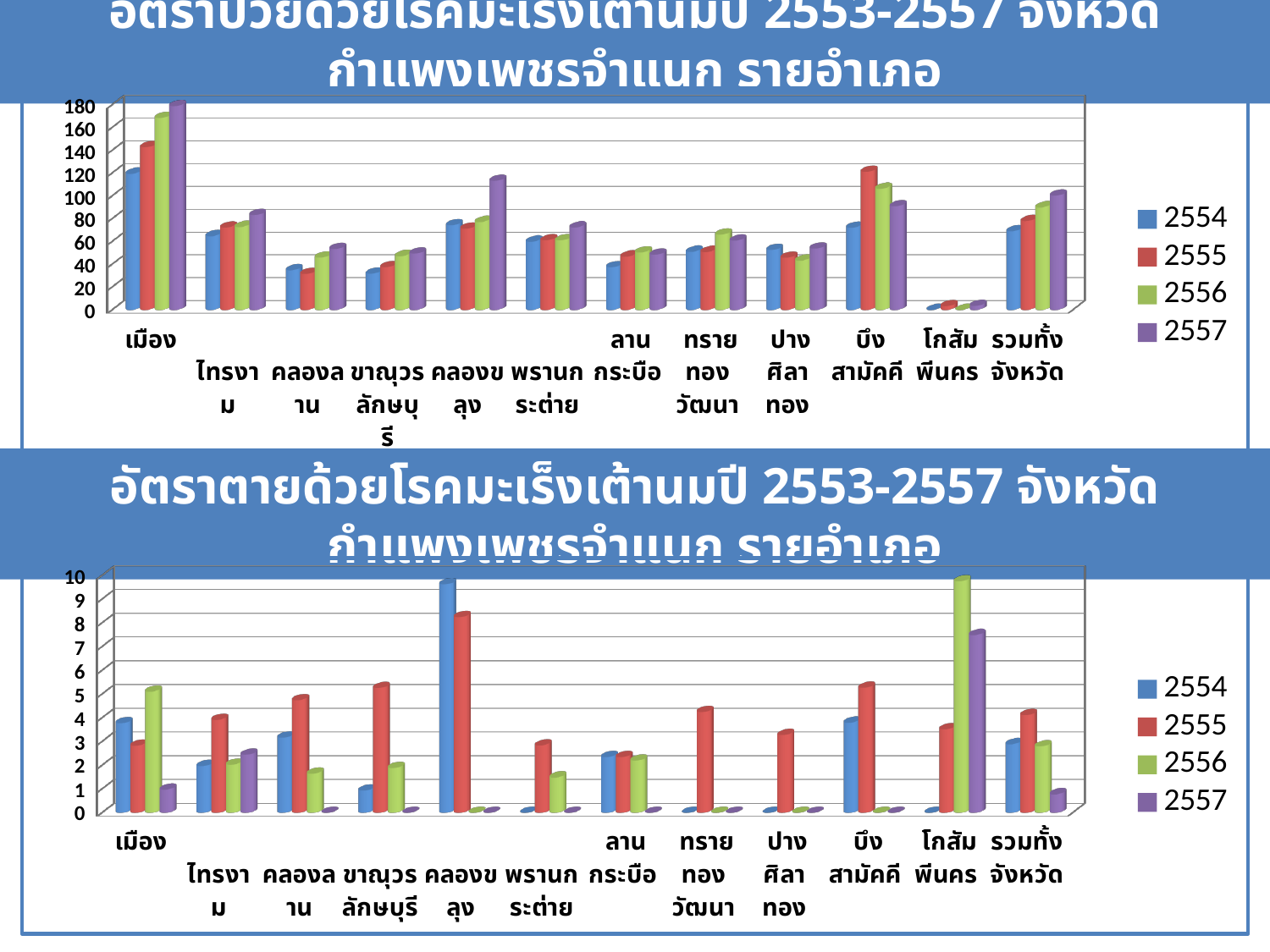
In the top chart, do the values for เมือง rise or fall from 2554 to 2557? rise In the top chart, is the 2554 value for เมือง greater or less than 100? greater What kind of chart is the top chart (อัตราป่วยด้วยโรคมะเร็งเต้านม)? bar chart In the top chart, which district has the lowest values across all years? โกสัมพีนคร How many district categories are shown on the x axis of the bottom chart (อัตราตายด้วยโรคมะเร็งเต้านม)? 12 What colour represents the year 2557 in the legends? purple In the bottom chart, which is larger for เมือง: the 2555 value or the 2556 value? 2556 In the bottom chart, is the 2554 value for คลองขลุง greater or less than 8? greater How many series does the legend of the top chart list? 4 In the bottom chart, which district has the tallest 2556 bar? โกสัมพีนคร In the top chart, is the 2554 value for คลองลาน greater or less than 40? less In the top chart, which year's bar is the tallest for เมือง? 2557